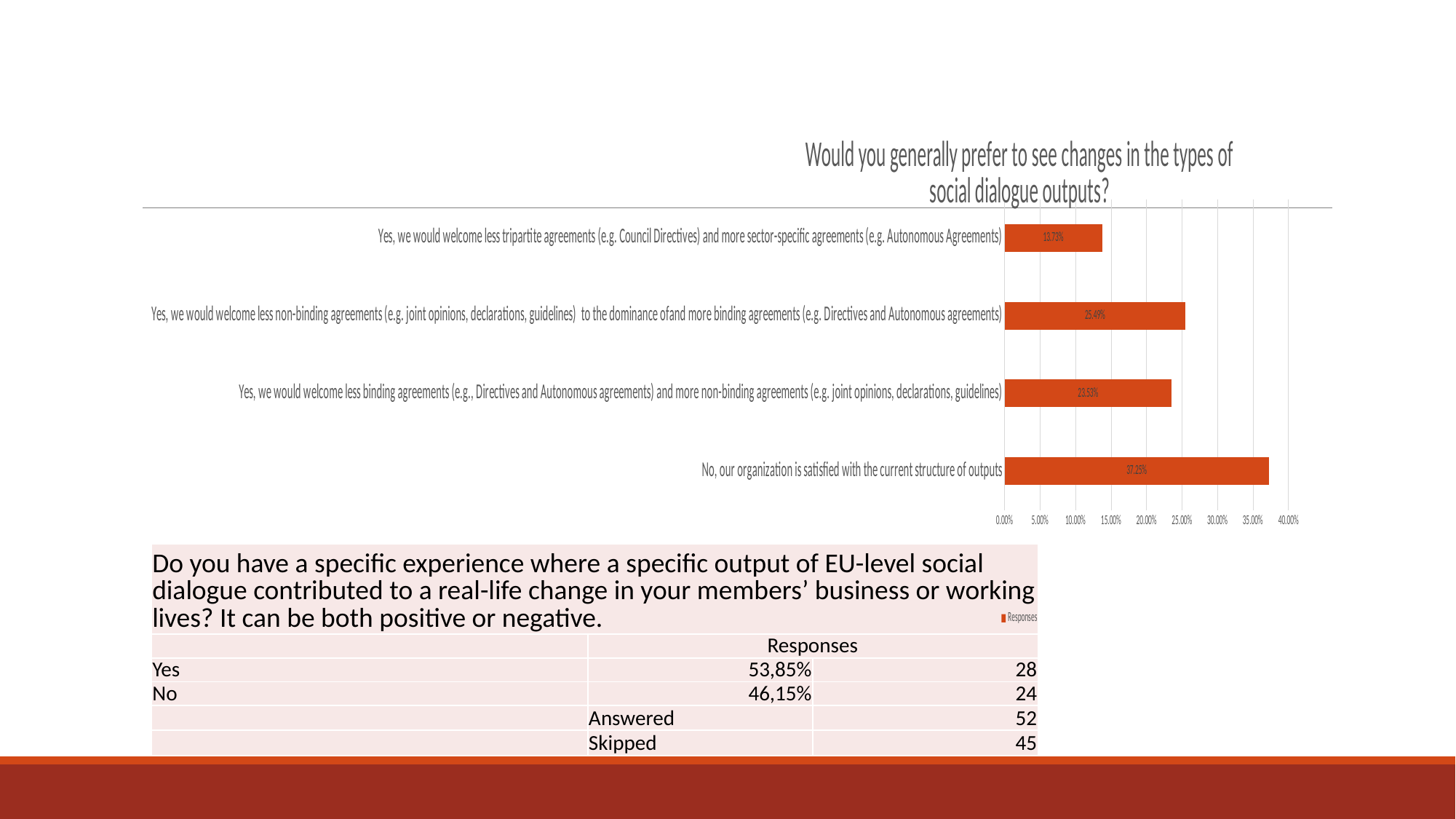
Which is larger: the value for the less non-binding agreements category or the value for the less binding agreements category? The less non-binding agreements category (25.49%) Is the value for "No, our organization is satisfied with the current structure of outputs" greater or less than 35.00%? greater What is the value for "Yes, we would welcome less tripartite agreements (e.g. Council Directives) and more sector-specific agreements (e.g. Autonomous Agreements)"? 13.73% What is the value for "Yes, we would welcome less binding agreements (e.g., Directives and Autonomous agreements) and more non-binding agreements (e.g. joint opinions, declarations, guidelines)"? 23.53% How many categories are shown in the chart? 4 Which category has the highest value? No, our organization is satisfied with the current structure of outputs What is the title of the chart? Would you generally prefer to see changes in the types of social dialogue outputs? What is the difference between the value for "No, our organization is satisfied with the current structure of outputs" and the value for the less tripartite agreements category? 23.52% What is the value for "No, our organization is satisfied with the current structure of outputs"? 37.25% What is the value for the category about welcoming less non-binding agreements and more binding agreements? 25.49% Which category has the lowest value? Yes, we would welcome less tripartite agreements (e.g. Council Directives) and more sector-specific agreements (e.g. Autonomous Agreements) What type of chart is shown on the slide? Bar chart